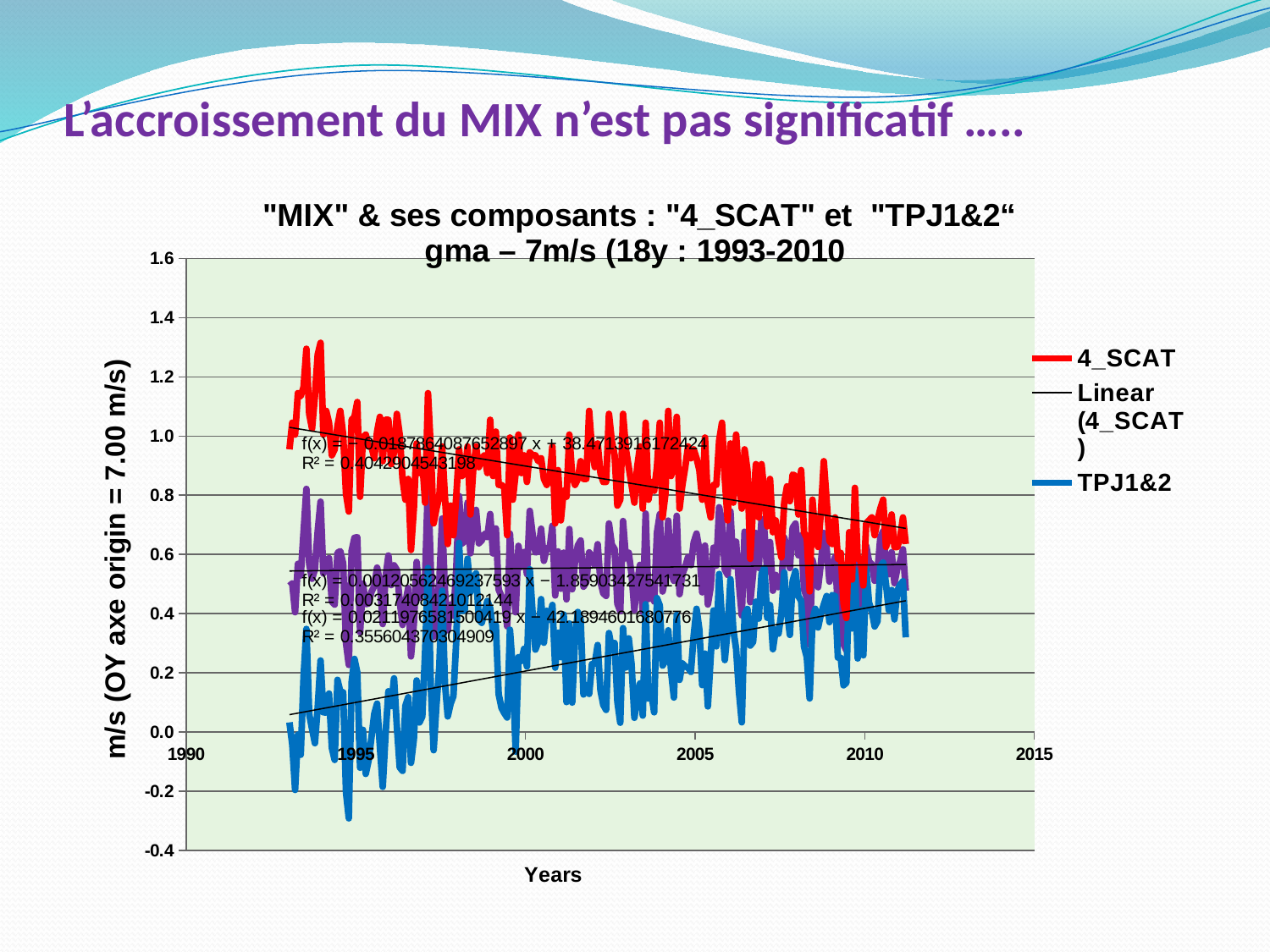
Which series has higher values overall, 4_SCAT or TPJ1&2? 4_SCAT Is the value for TPJ1&2 around 1994 greater or less than 0.4? less Is the value for 4_SCAT around 1994 greater or less than 0.8? greater Do the values of the 4_SCAT series rise or fall over the years shown? fall What kind of chart is shown on the slide? line chart Is the value for 4_SCAT around 2010 greater or less than 1.0? less Do the values of the TPJ1&2 series rise or fall over the years shown? rise What is the label of the horizontal axis? Years What is the highest value shown on the vertical axis? 1.6 How many entries does the chart legend list? 3